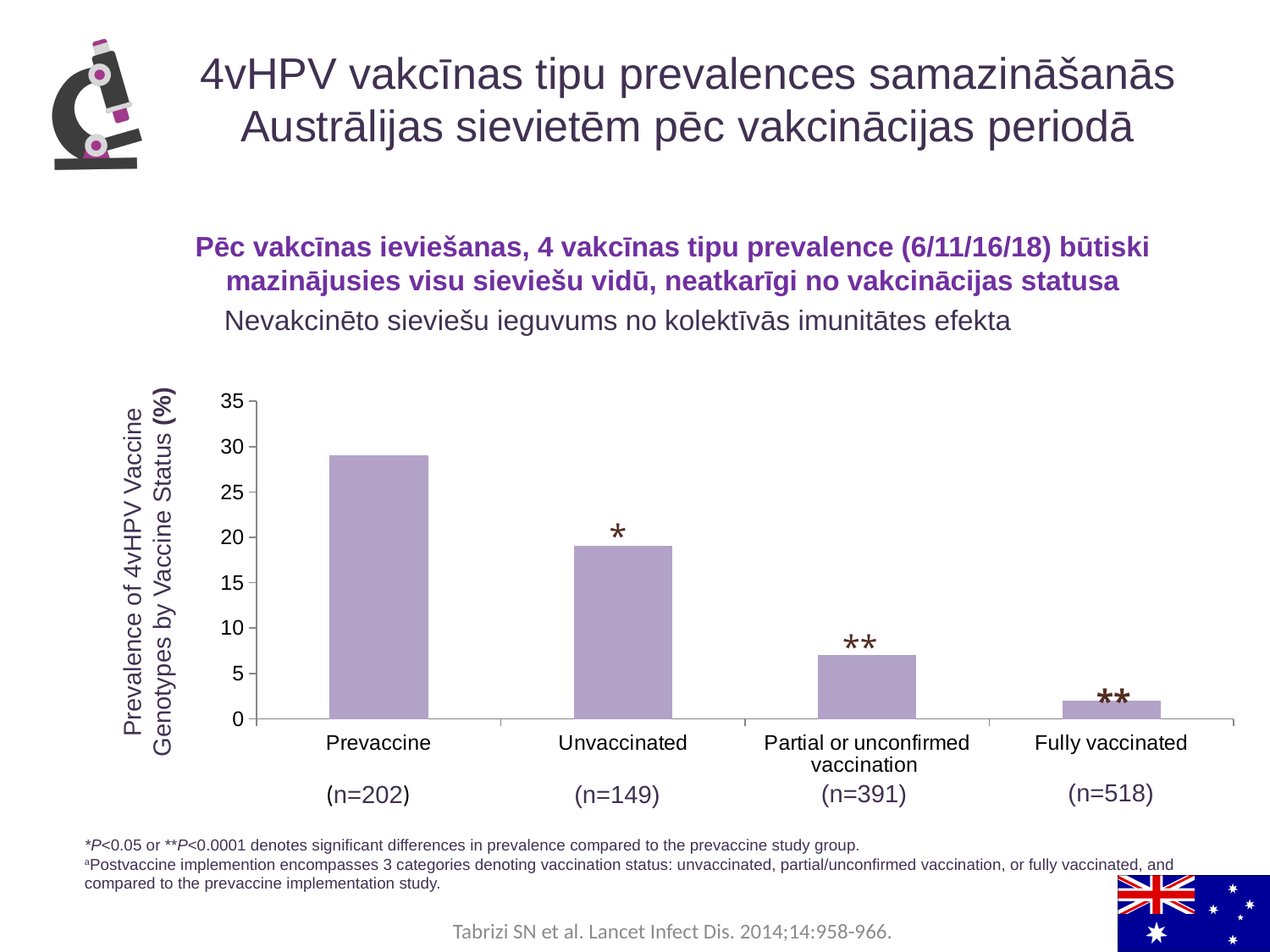
Which category has the highest prevalence of 4vHPV vaccine genotypes? Prevaccine Is the value for Unvaccinated greater or less than 20? less Do the values rise or fall moving from left to right along the x axis? fall What kind of chart is shown on the slide? bar chart Is the value for Prevaccine greater or less than 25? greater Is the value for Fully vaccinated greater or less than 5? less What is the sample size (n) shown for the Fully vaccinated group? n=518 Which is larger, the value for Unvaccinated or the value for Partial or unconfirmed vaccination? Unvaccinated How many categories are shown on the x axis of the chart? 4 Which category has the lowest prevalence of 4vHPV vaccine genotypes? Fully vaccinated What is the label of the y axis of the chart? Prevalence of 4vHPV Vaccine Genotypes by Vaccine Status (%)